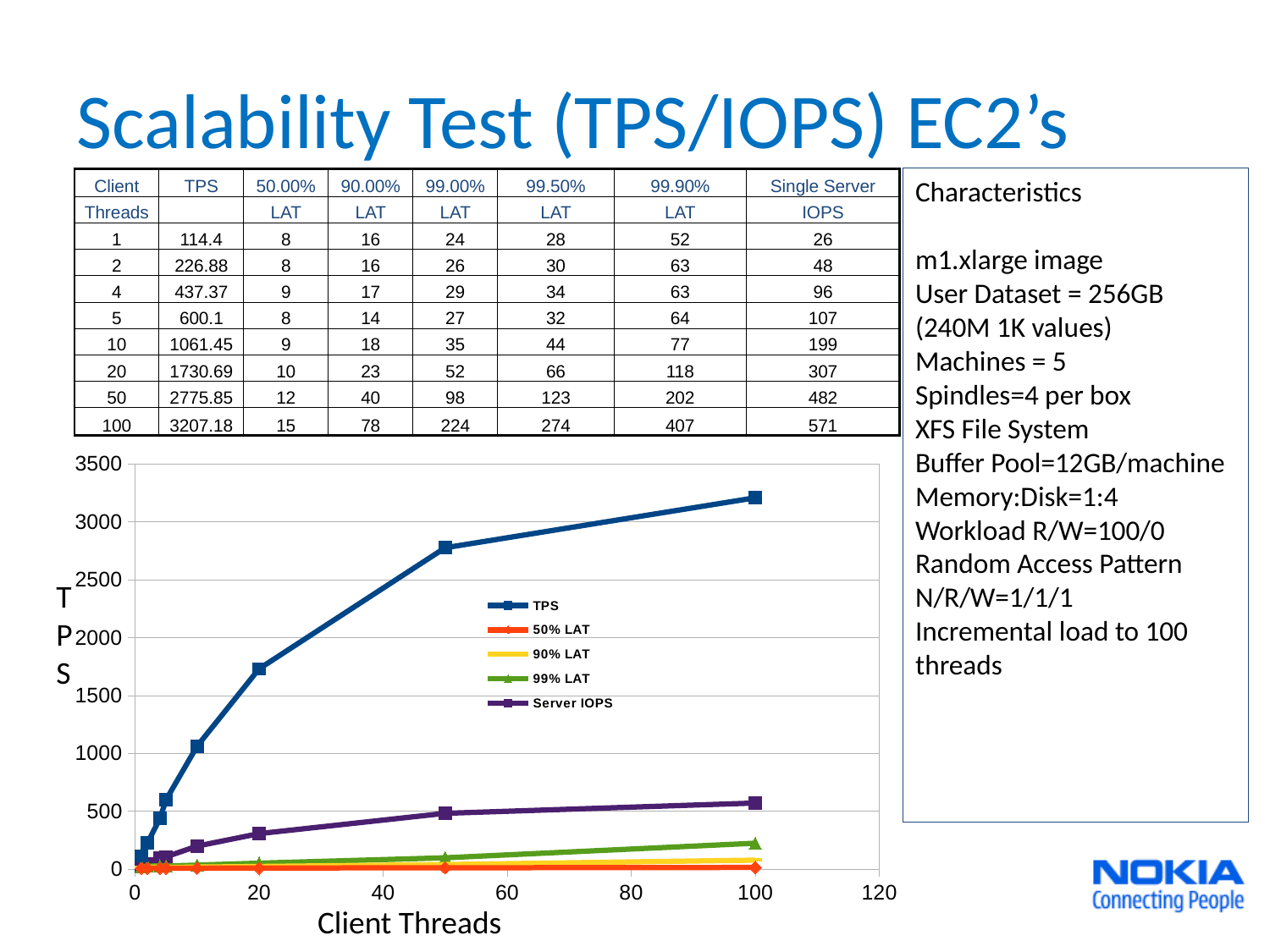
Is the TPS value at 50 client threads greater or less than 2500? greater What is the 99% LAT value at 100 client threads? 224 What is the Server IOPS value at 50 client threads? 482 Does TPS rise or fall as the number of client threads increases? rises What kind of chart is shown on the slide? line chart Which series has the lowest value at 100 client threads? 50% LAT Which series reaches the highest value on the chart? TPS What is the TPS value at 100 client threads? 3207.18 At 100 client threads, which is larger: Server IOPS or 99% LAT? Server IOPS What is the difference between TPS at 100 client threads and TPS at 50 client threads? 431.33 What is the label of the x axis of the chart? Client Threads How many series does the chart legend list? 5